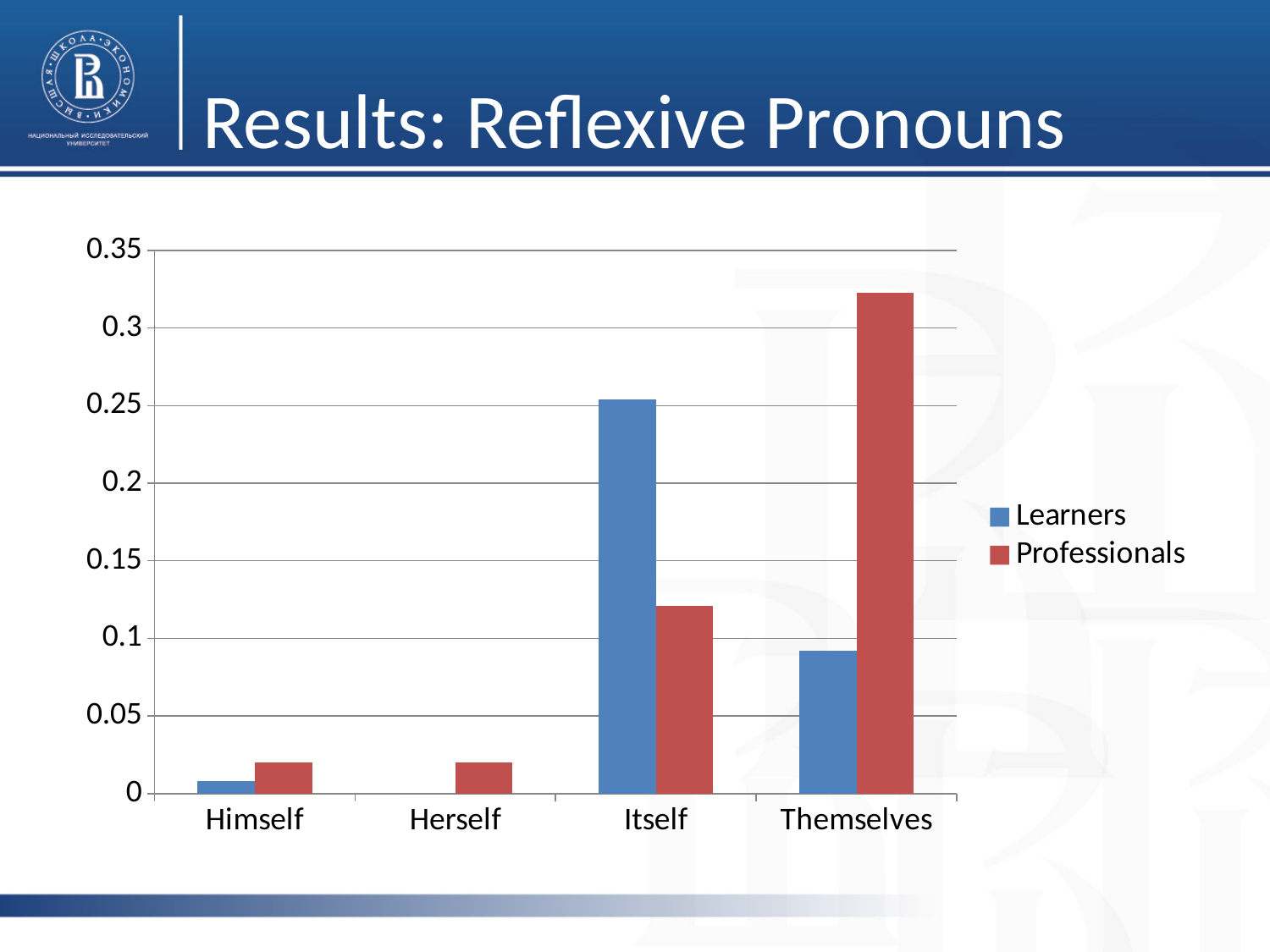
Which category has the highest value for Learners? Itself Is the Learners value for Themselves greater or less than 0.1? less What colour are the Professionals bars? red Which category has the lowest value for Learners? Herself How many categories are shown on the x axis? 4 For Themselves, which is larger: the Learners value or the Professionals value? Professionals Is the Learners value for Itself greater or less than 0.2? greater How many series does the legend list? 2 What kind of chart is shown on the slide? bar chart Which category has the highest value for Professionals? Themselves Is the Professionals value for Themselves greater or less than 0.3? greater For Itself, which is larger: the Learners value or the Professionals value? Learners